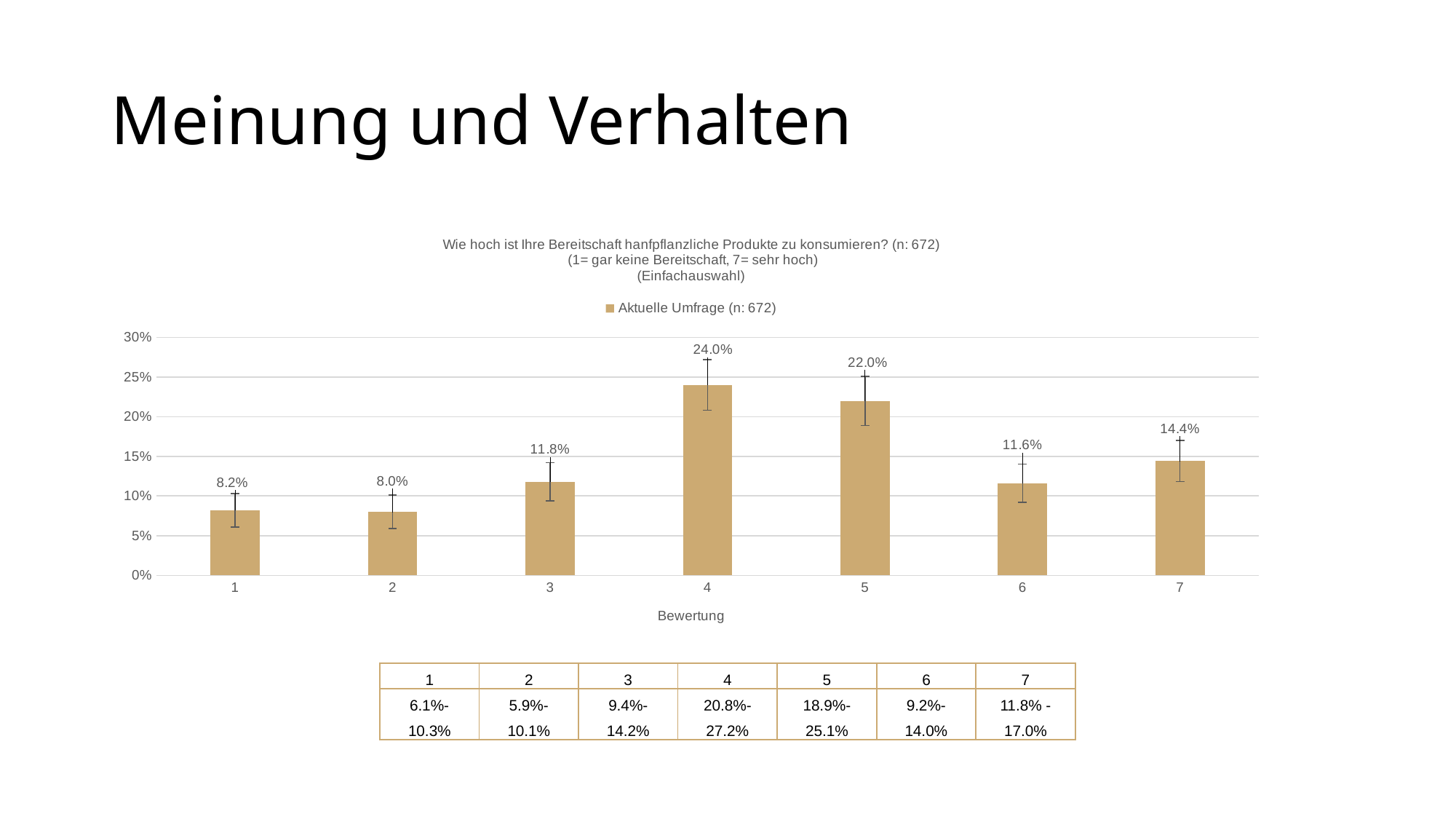
What is the value for rating 7? 14.4% What is the difference between the values for rating 4 and rating 5? 2.0% What is the value for rating 4? 24.0% Which is larger, the value for rating 3 or the value for rating 7? 7 Which rating has the highest value? 4 Which rating has the lowest value? 2 What is the difference between the values for rating 7 and rating 6? 2.8% What is the legend entry for the series? Aktuelle Umfrage (n: 672) What kind of chart is shown? bar chart What is the value for rating 2? 8.0% Is the value for rating 5 greater or less than 20%? greater How many rating categories are shown on the x axis? 7